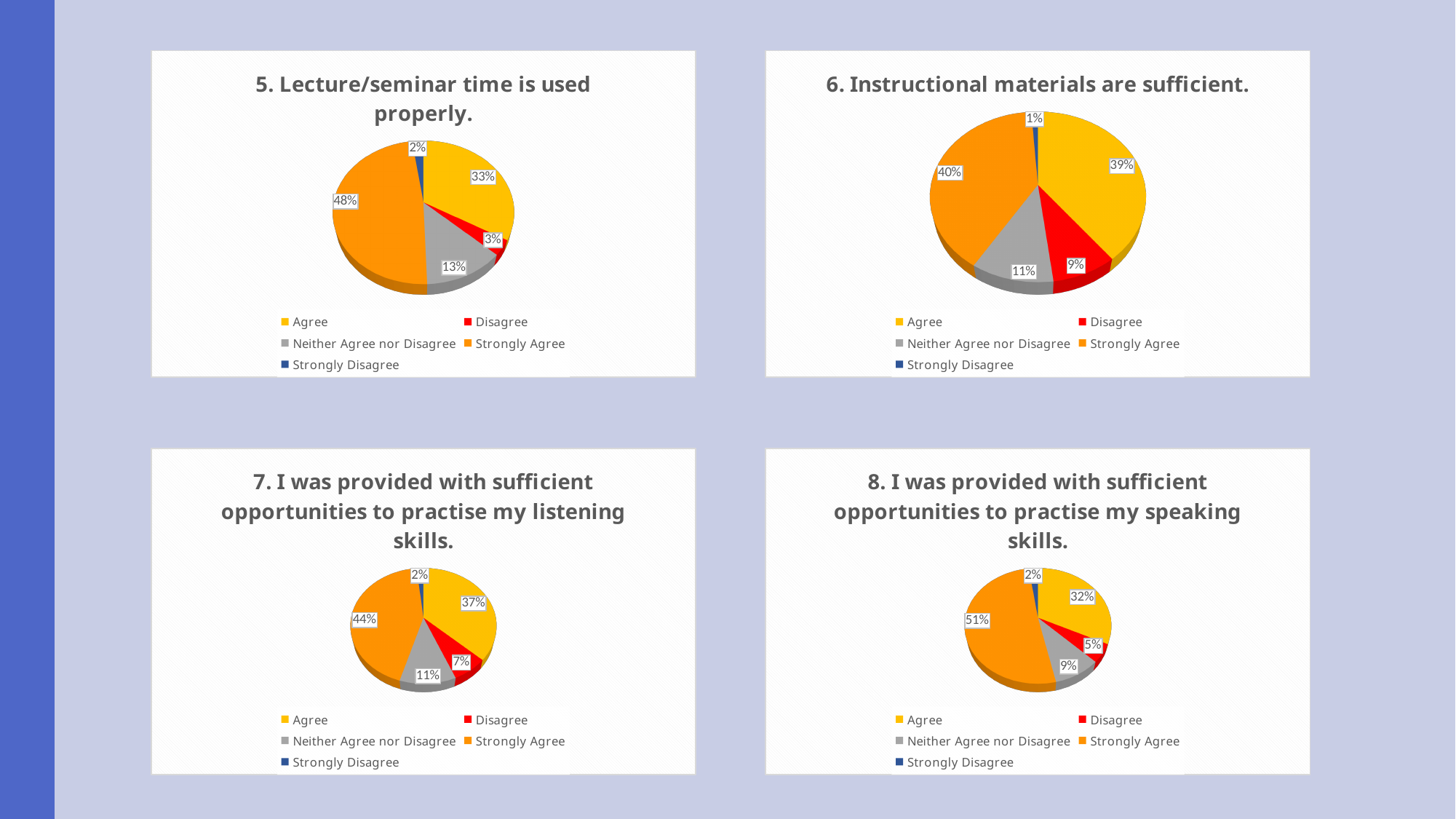
In the chart titled "8. I was provided with sufficient opportunities to practise my speaking skills.", what is the difference between the Strongly Agree and Agree shares? 19% In the chart titled "7. I was provided with sufficient opportunities to practise my listening skills.", what share of responses is Agree? 37% What kind of chart is used for "6. Instructional materials are sufficient."? Pie chart In the chart titled "6. Instructional materials are sufficient.", which response category has the smallest slice? Strongly Disagree In the chart titled "5. Lecture/seminar time is used properly.", which is larger, the Disagree slice or the Neither Agree nor Disagree slice? Neither Agree nor Disagree How many response categories does the legend list in the chart titled "7. I was provided with sufficient opportunities to practise my listening skills."? 5 In the chart titled "7. I was provided with sufficient opportunities to practise my listening skills.", which response category has the largest slice? Strongly Agree In the chart titled "5. Lecture/seminar time is used properly.", what share of responses is Neither Agree nor Disagree? 13% In the chart titled "6. Instructional materials are sufficient.", what share of responses is Disagree? 9% In the chart titled "8. I was provided with sufficient opportunities to practise my speaking skills.", what colour represents Strongly Disagree in the legend? Blue In the chart titled "8. I was provided with sufficient opportunities to practise my speaking skills.", what share of responses is Strongly Agree? 51% In the chart titled "5. Lecture/seminar time is used properly.", what share of responses is Strongly Agree? 48%